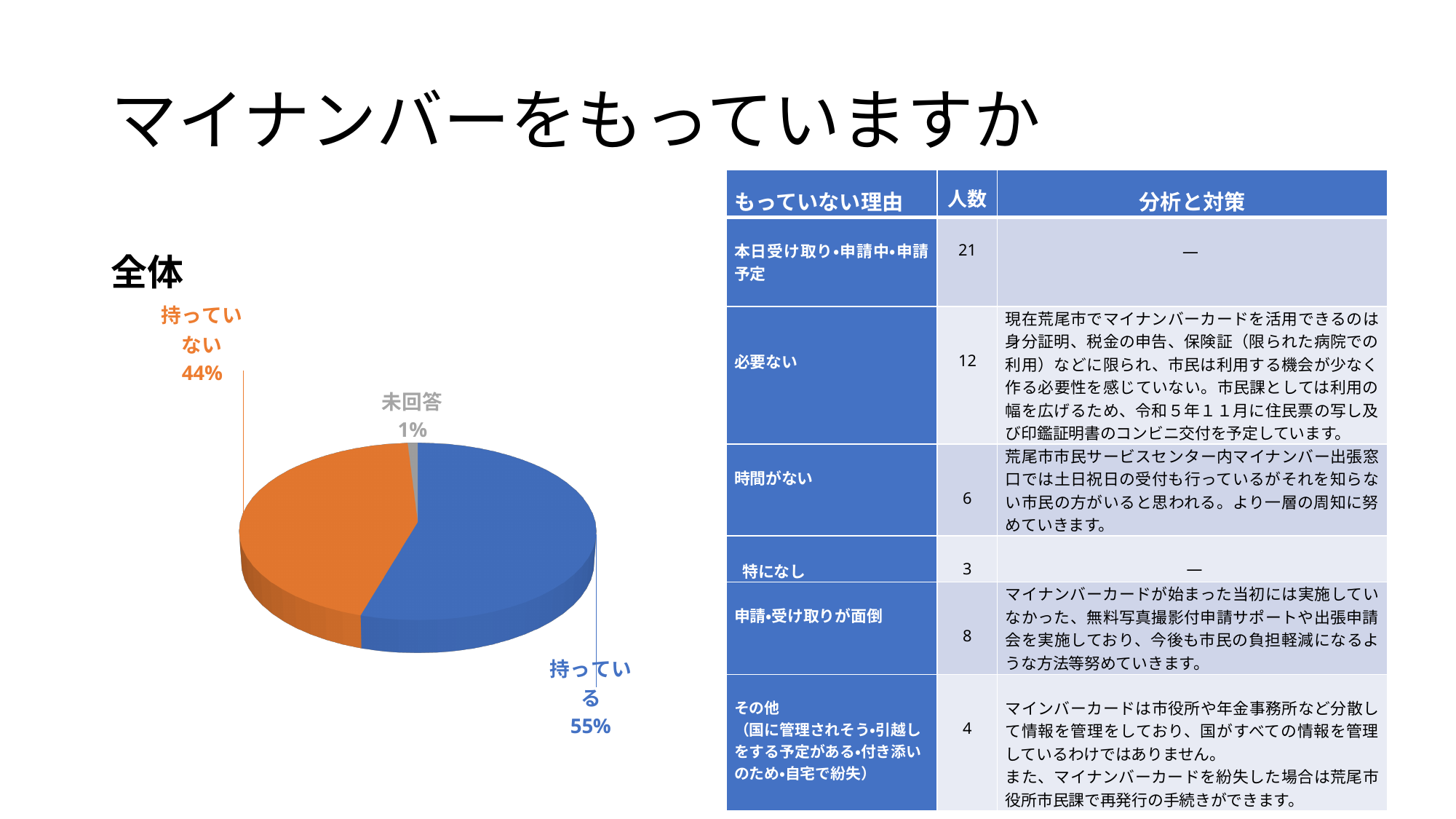
What colour is the 持っていない slice of the pie chart? orange Which slice of the pie chart is the smallest? 未回答 What is the difference in percentage points between 持っている and 持っていない? 11 Which is larger, the share for 持っていない or the share for 未回答? 持っていない What is the title shown above the pie chart? 全体 What kind of chart is shown on the slide? pie chart Which slice of the pie chart is the largest? 持っている How many slices does the pie chart have? 3 What share of the pie does 持っていない represent? 44% Which is larger, the share for 持っている or the share for 持っていない? 持っている What share of the pie does 持っている represent? 55% What share of the pie does 未回答 represent? 1%